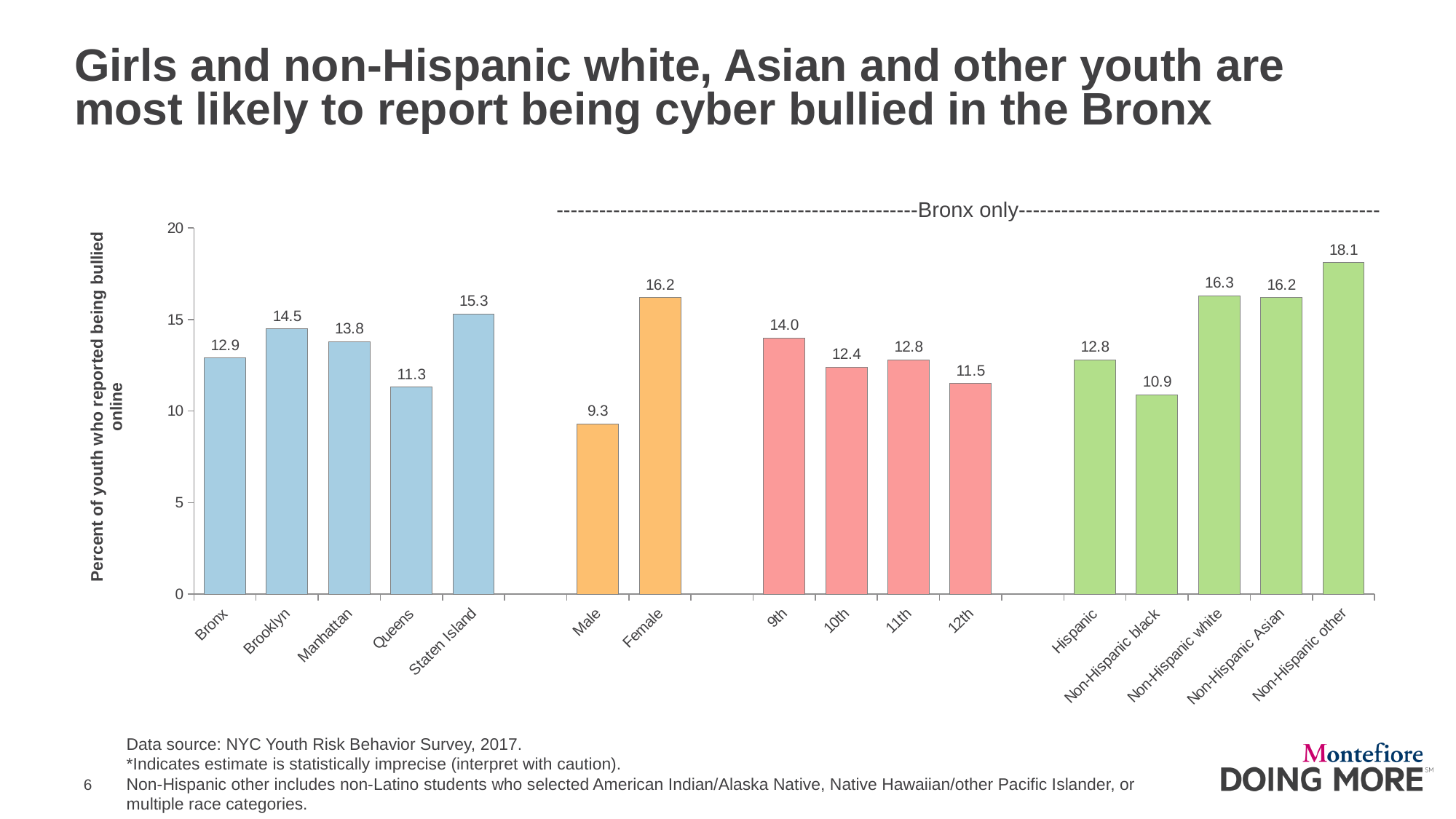
Which category across the whole chart has the highest value? Non-Hispanic other Which borough has the highest percent of youth who reported being bullied online? Staten Island Which is larger, the value for Queens or the value for Manhattan? Manhattan What is the value for Female in the chart? 16.2 What is the label on the vertical axis of the chart? Percent of youth who reported being bullied online What is the difference between the Female and Male values? 6.9 What kind of chart is shown on the slide? bar chart Which category across the whole chart has the lowest value? Male Is the value for 9th grade greater or less than 15? less What percent of youth in Brooklyn reported being bullied online? 14.5 How many categories (bars) are shown in the chart? 16 What is the value for Non-Hispanic black? 10.9